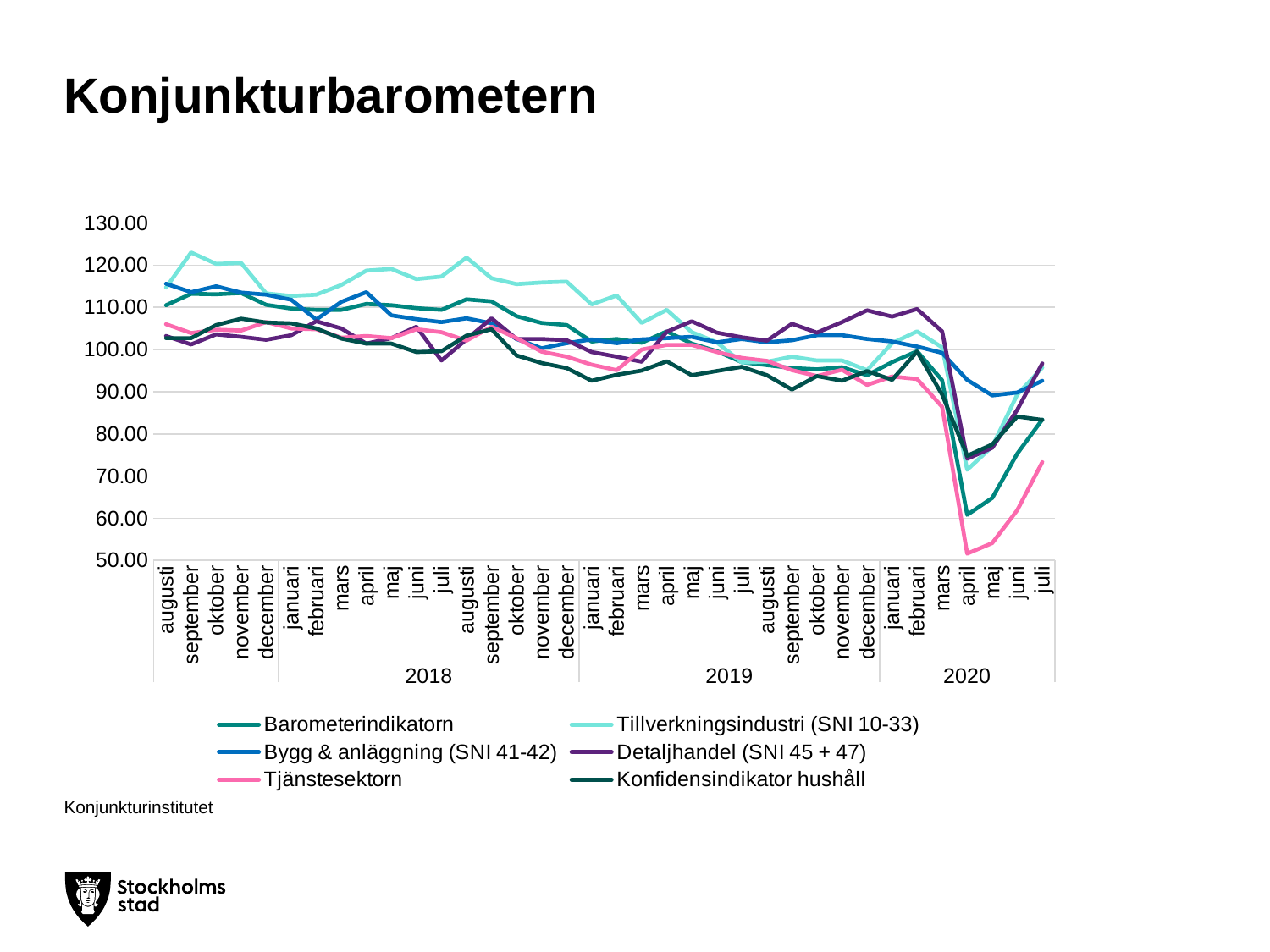
What is the title of the chart? Konjunkturbarometern Is the value for Barometerindikatorn in april 2020 greater or less than 70? less How many series does the legend list? 6 Which series has the lowest value in april 2020? Tjänstesektorn Is the value for Bygg & anläggning (SNI 41-42) in april 2020 greater or less than 100? less How many monthly points are plotted along the x axis? 36 Is the value for Tillverkningsindustri (SNI 10-33) in september 2017 greater or less than 120? greater Which source is cited below the chart? Konjunkturinstitutet What kind of chart is shown on the slide? line chart In juli 2020, which is larger: Detaljhandel (SNI 45 + 47) or Tjänstesektorn? Detaljhandel (SNI 45 + 47) Which series has the highest value in september 2017? Tillverkningsindustri (SNI 10-33)